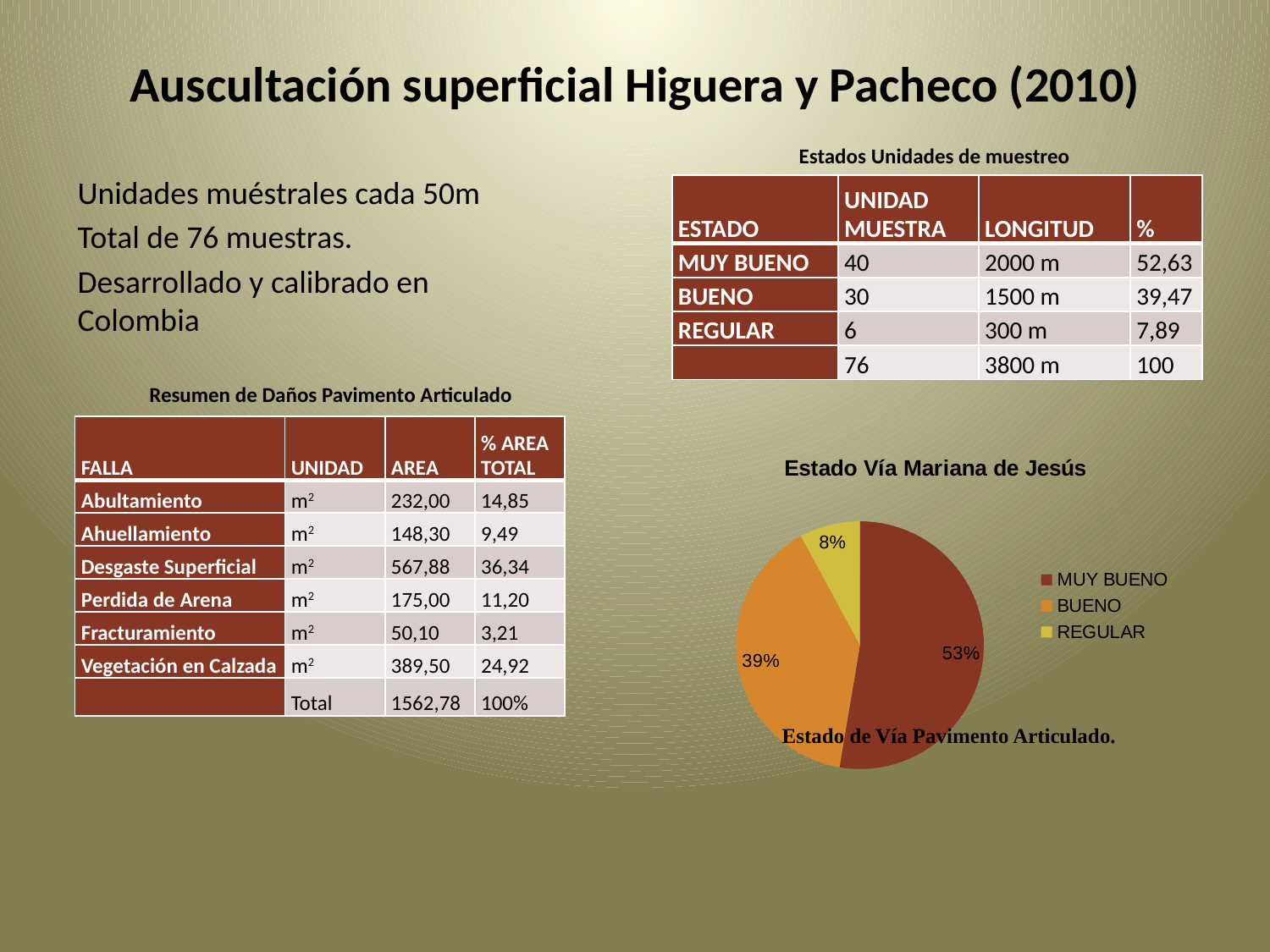
Which category has the smallest slice in the pie chart? REGULAR What share of the pie chart does MUY BUENO represent? 53% What share of the pie chart does REGULAR represent? 8% In the pie chart, which is larger, BUENO or REGULAR? BUENO How many entries does the pie chart legend list? 3 What share of the pie chart does BUENO represent? 39% What is the difference in percentage points between the BUENO and REGULAR slices of the pie chart? 31 What is the title of the pie chart? Estado Vía Mariana de Jesús How many slices does the pie chart have? 3 What kind of chart is shown on the slide? pie chart What is the difference in percentage points between the MUY BUENO and BUENO slices of the pie chart? 14 Which category has the largest slice in the pie chart? MUY BUENO